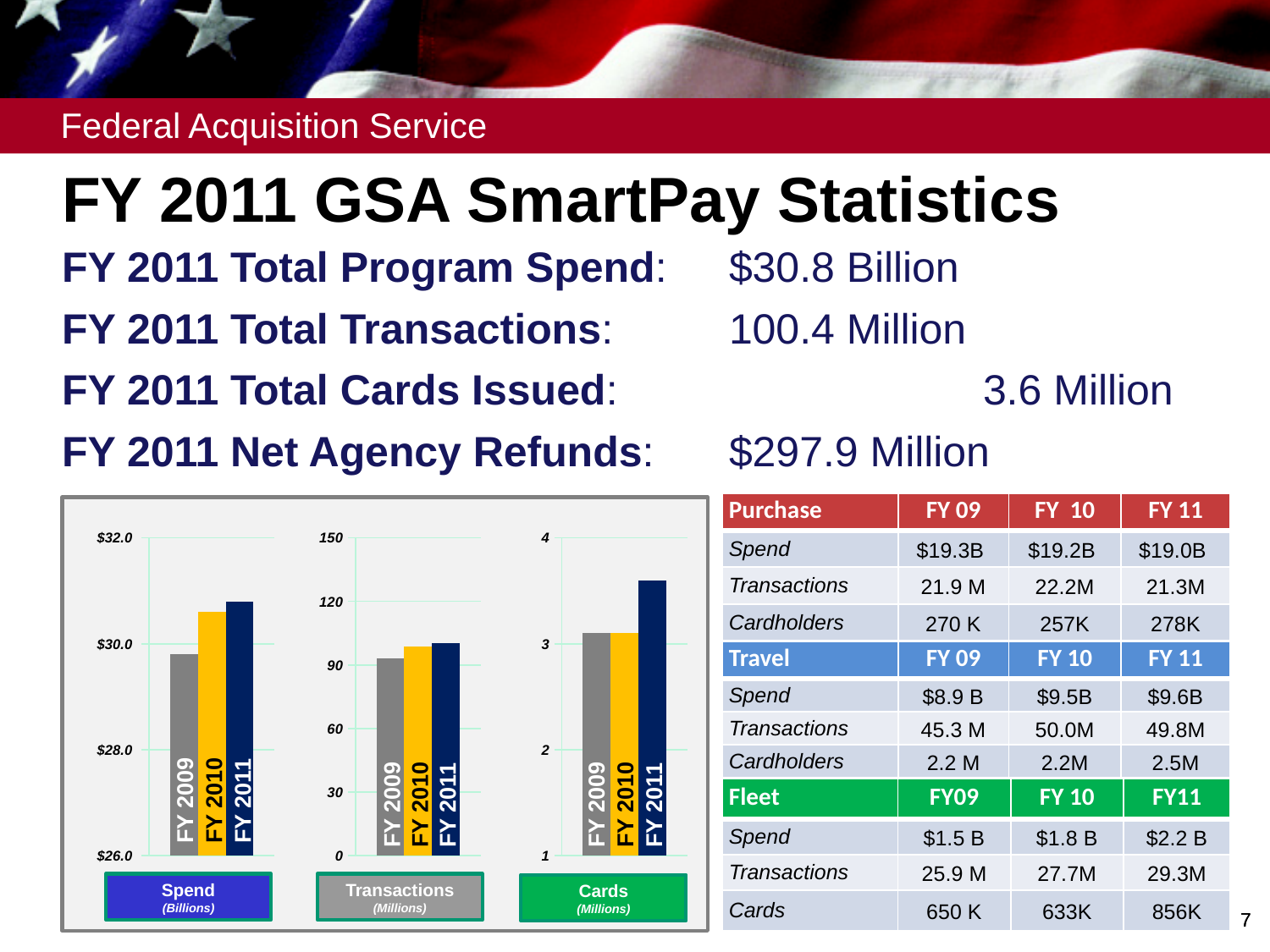
In the Transactions chart, is the value for FY 2011 greater or less than 120? less In the Spend chart, which is larger, the bar for FY 2009 or the bar for FY 2010? FY 2010 What kind of chart is the Spend chart on the slide? bar chart In the Spend chart, which fiscal year has the highest bar? FY 2011 In the Spend chart, is the value for FY 2009 greater or less than $30.0? less How many bars does the Cards chart show? 3 In the Spend chart, which fiscal year has the lowest bar? FY 2009 In the Transactions chart, which fiscal year has the lowest bar? FY 2009 In the Spend chart, is the value for FY 2011 greater or less than $30.0? greater In the Cards chart, do the values rise or fall from FY 2009 to FY 2011? rise In the Cards chart, which fiscal year has the highest bar? FY 2011